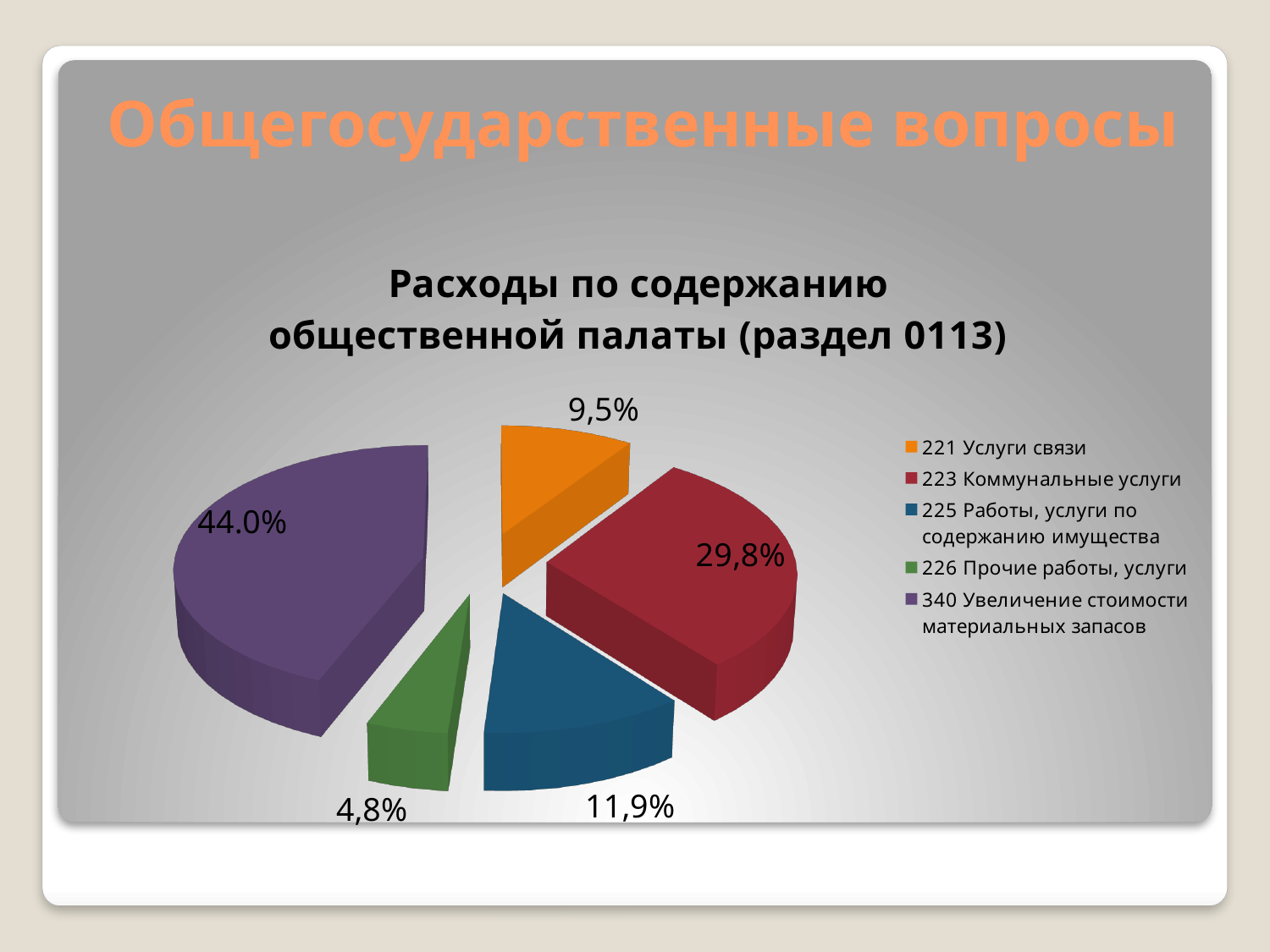
What share of the pie is labelled for 221 Услуги связи? 9,5% Which is larger: the share for 223 Коммунальные услуги or the share for 225 Работы, услуги по содержанию имущества? 223 Коммунальные услуги What share of the pie is labelled for 340 Увеличение стоимости материальных запасов? 44.0% What is the title of the chart? Расходы по содержанию общественной палаты (раздел 0113) Which category has the smallest slice of the pie? 226 Прочие работы, услуги What share of the pie is labelled for 223 Коммунальные услуги? 29,8% Which category has the largest slice of the pie? 340 Увеличение стоимости материальных запасов How many slices does the pie chart have? 5 What kind of chart is shown on the slide? pie chart How many series does the legend list? 5